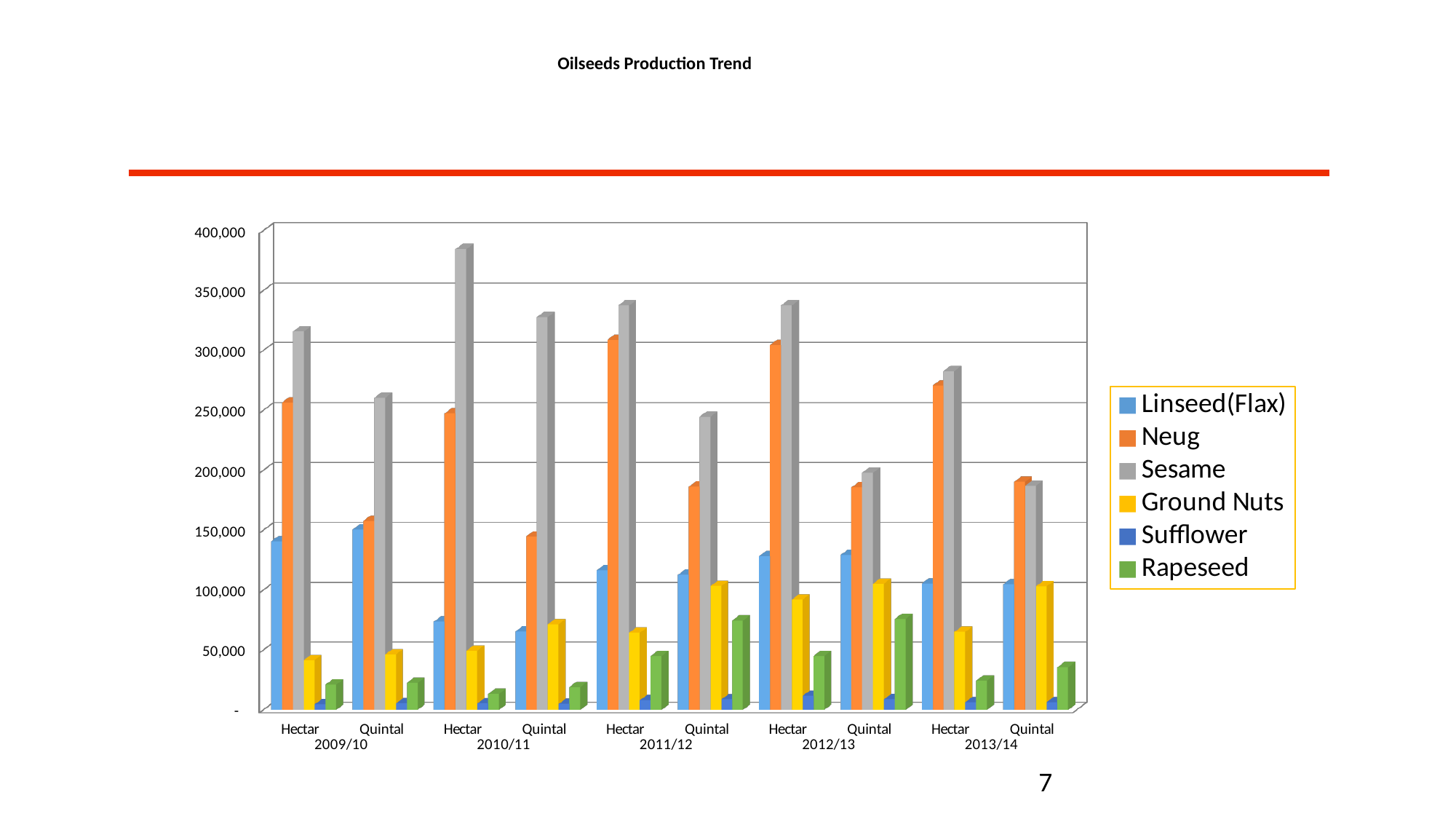
What is the title of the slide? Oilseeds Production Trend How many category groups are shown along the x axis? 10 Is the Rapeseed value for Quintal 2012/13 greater or less than 50,000? greater How many series does the legend list? 6 Is the Sesame value for Hectar 2009/10 greater or less than 300,000? greater Is the Ground Nuts value for Hectar 2009/10 greater or less than 50,000? less In the Hectar 2010/11 group, which is larger, Sesame or Neug? Sesame Which series has the lowest bar in the Hectar 2009/10 group? Sufflower Which series has the tallest bar in the Hectar 2010/11 group? Sesame What kind of chart is shown on the slide? Bar chart In the Quintal 2011/12 group, which is larger, Ground Nuts or Rapeseed? Ground Nuts